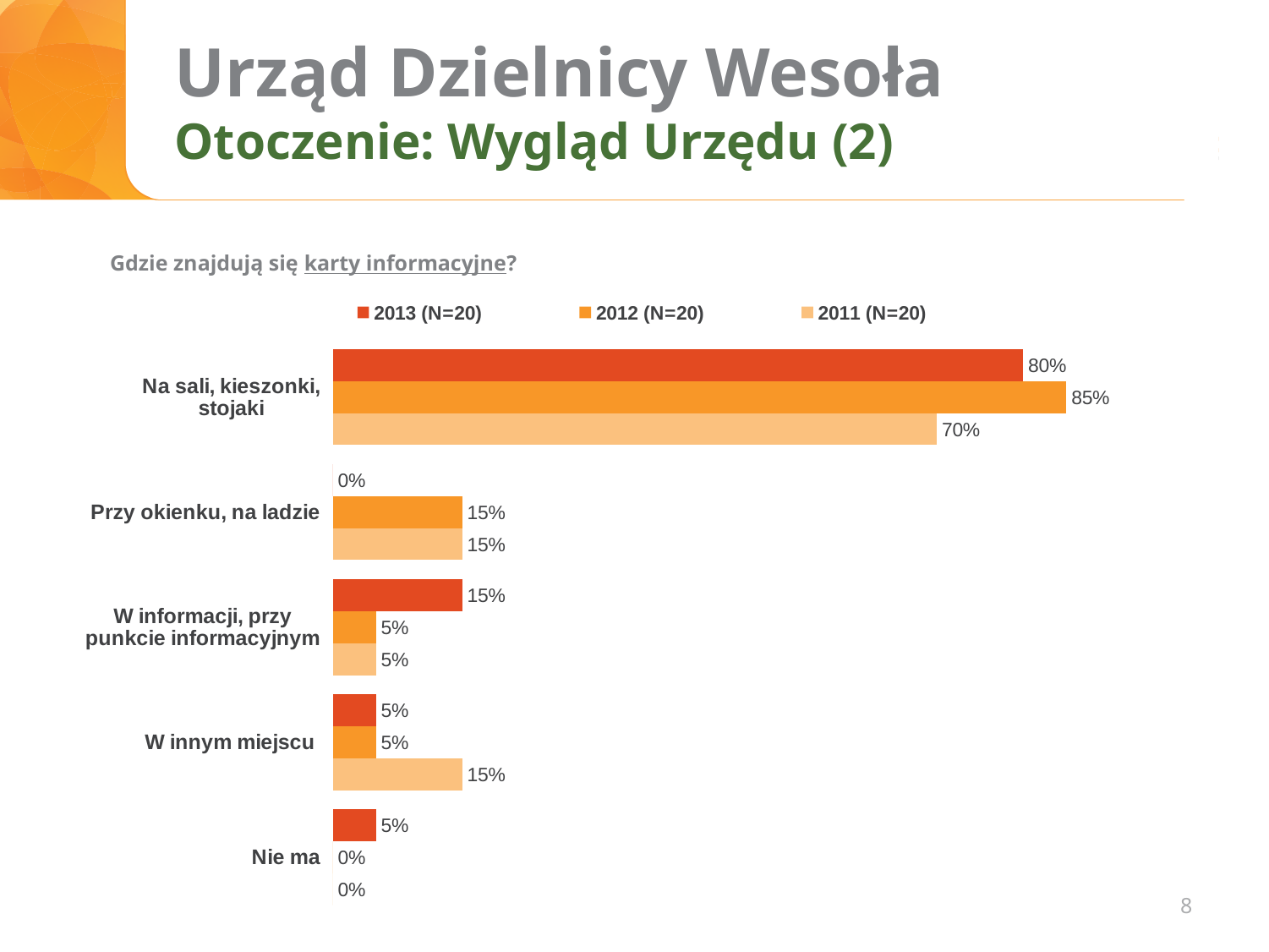
What is the value for "W innym miejscu" in the 2011 (N=20) series? 15% What question does the chart answer, as stated above it? Gdzie znajdują się karty informacyjne? What is the value for "Nie ma" in the 2013 (N=20) series? 5% Which category has the lowest value in the 2013 (N=20) series? Przy okienku, na ladzie What is the value for "Na sali, kieszonki, stojaki" in the 2013 (N=20) series? 80% How many series does the legend list? 3 What kind of chart is shown on the slide? Bar chart What is the value for "Przy okienku, na ladzie" in the 2012 (N=20) series? 15% How many categories are shown on the chart? 5 Which category has the highest value in the 2012 (N=20) series? Na sali, kieszonki, stojaki For "W informacji, przy punkcie informacyjnym", which series has the larger value: 2013 (N=20) or 2012 (N=20)? 2013 (N=20) What is the difference between the 2012 (N=20) and 2011 (N=20) values for "Na sali, kieszonki, stojaki"? 15%